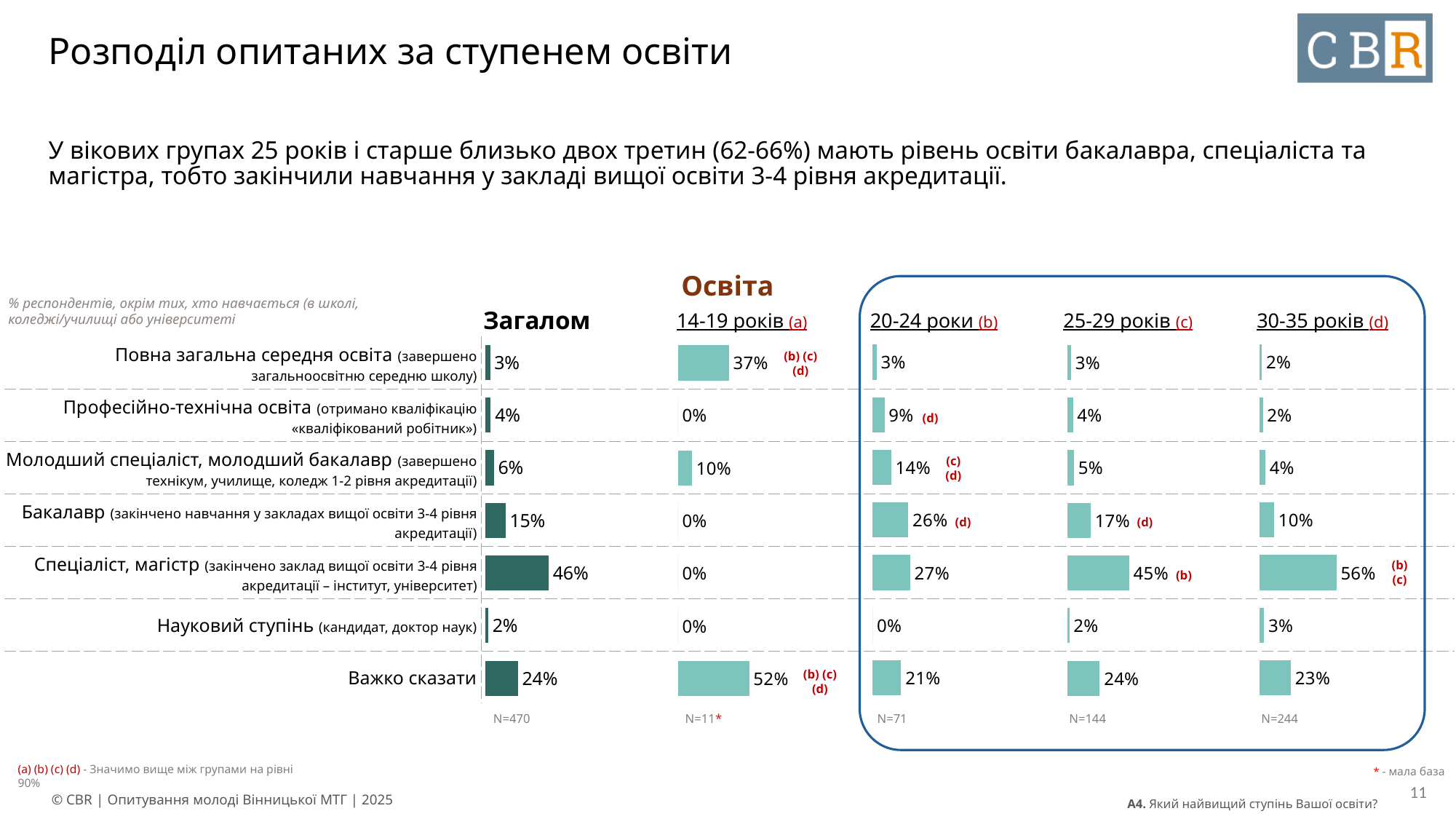
In the 25-29 років column, what is the difference between Спеціаліст, магістр and Бакалавр? 28 percentage points In the 30-35 років column, what is the value for Бакалавр? 10% For Бакалавр, which age group has the larger value: 20-24 роки or 25-29 років? 20-24 роки In the 20-24 роки column, what is the value for Професійно-технічна освіта? 9% In the Загалом column, what is the difference between Важко сказати and Бакалавр? 9 percentage points What is the sample size (N) shown for the 25-29 років column? N=144 How many education categories are shown in the chart? 7 In the Загалом column, which education category has the lowest value? Науковий ступінь In the 30-35 років column, which education category has the highest value? Спеціаліст, магістр In the 14-19 років column, what is the value for Важко сказати? 52% What kind of chart is used on this slide? Bar chart In the Загалом column, what is the value for Спеціаліст, магістр? 46%